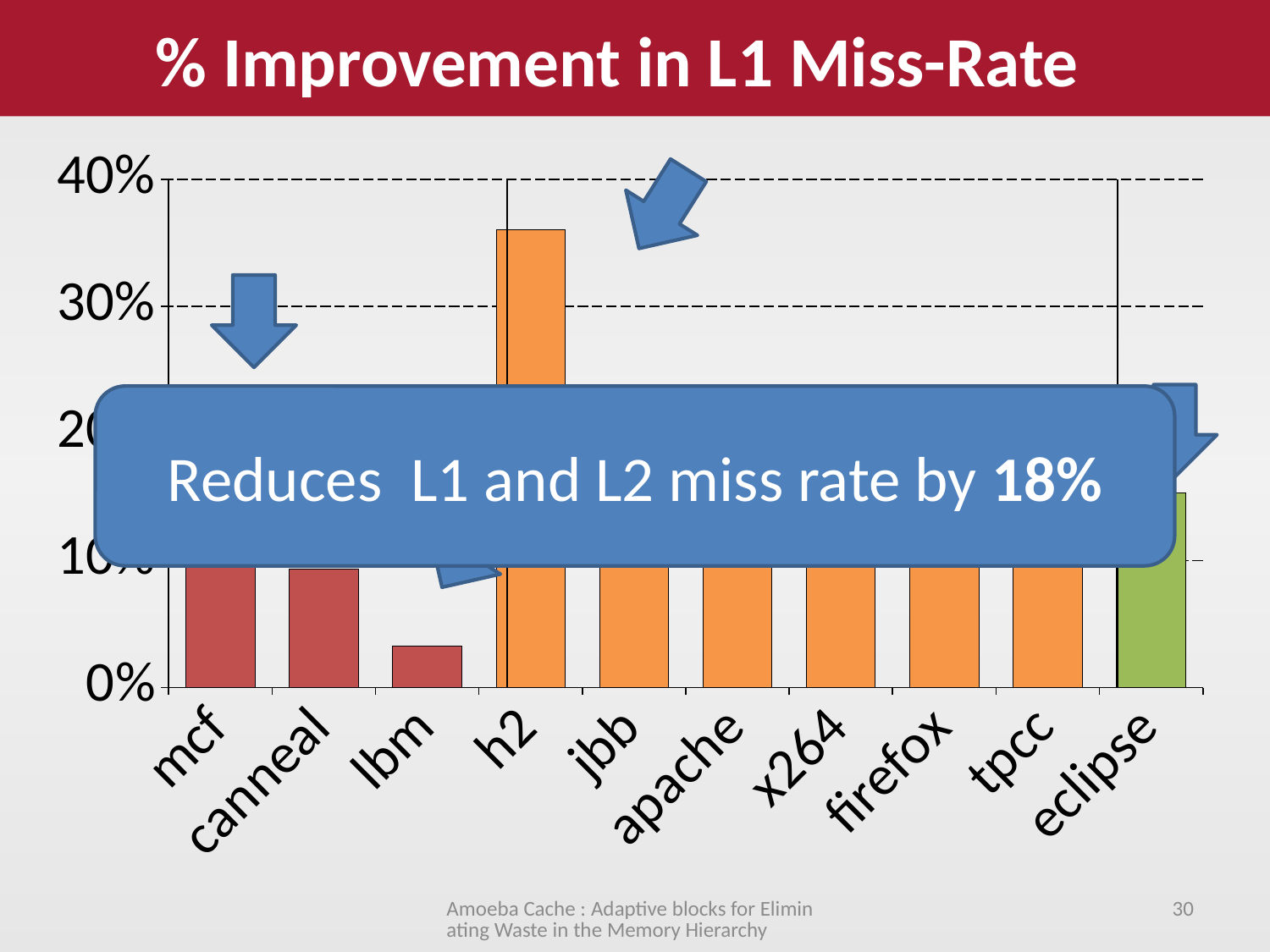
What kind of chart is shown on the slide? bar chart Which benchmark has the highest % improvement in L1 miss-rate? h2 Which is larger, the value for eclipse or the value for lbm? eclipse Which benchmark has the lowest % improvement in L1 miss-rate? lbm What is the title of the chart? % Improvement in L1 Miss-Rate Is the value for eclipse greater or less than 10%? greater How many benchmark categories are shown on the x axis? 10 Is the value for lbm greater or less than 10%? less By what percentage does the callout say L1 and L2 miss rate is reduced? 18% Which is larger, the value for h2 or the value for lbm? h2 Is the value for h2 greater or less than 30%? greater